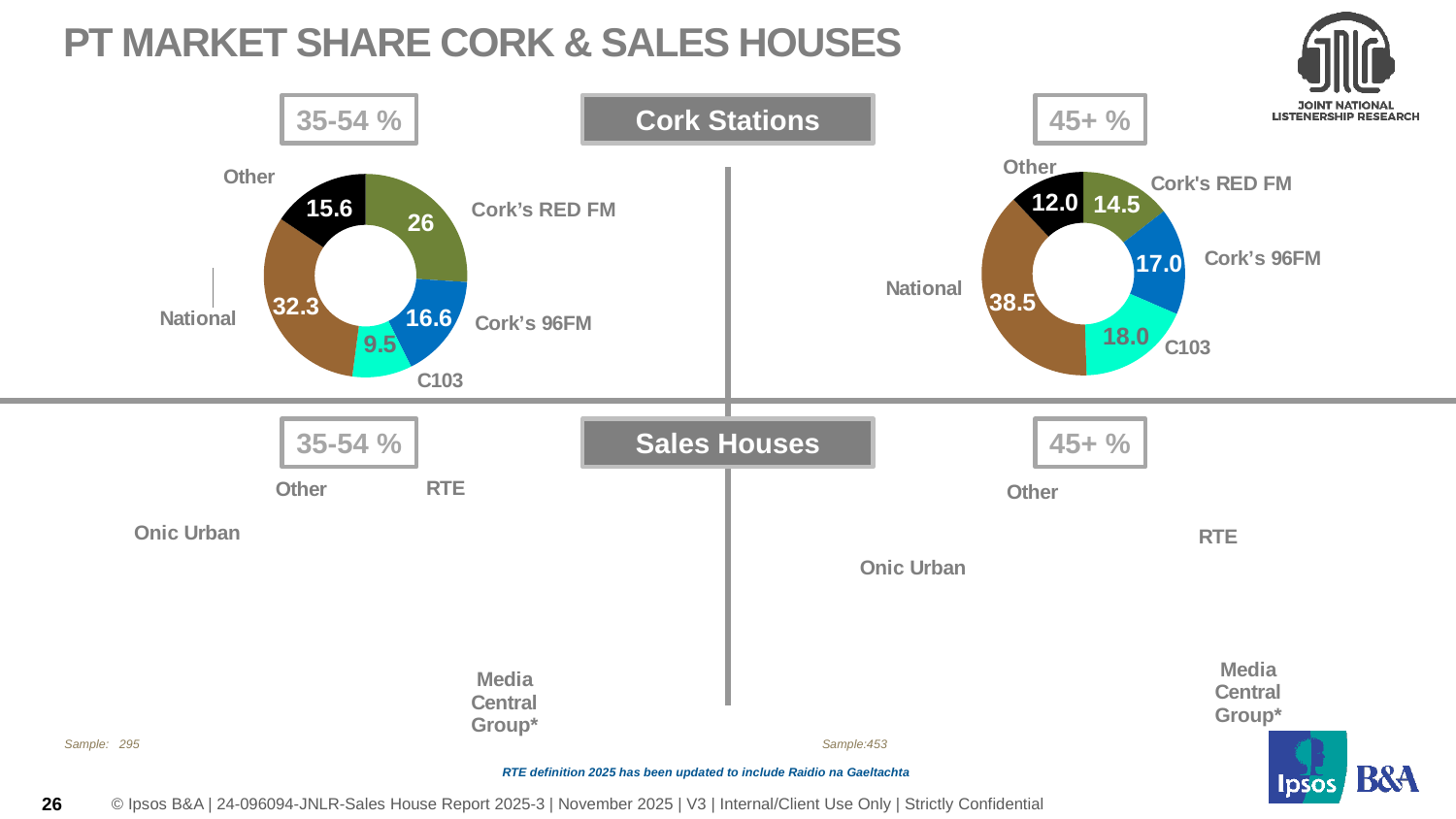
In the Cork Stations 35-54 chart, what is the value for National? 32.3 In the Cork Stations 45+ chart, which category has the smallest value? Other In the Cork Stations 35-54 chart, what is the difference between Cork's RED FM and C103? 16.5 In the Cork Stations 45+ chart, what is the value for Other? 12.0 In the Cork Stations 45+ chart, which is larger, Cork's RED FM or C103? C103 In the Cork Stations 35-54 chart, what is the value for Cork's RED FM? 26 In the Cork Stations 45+ chart, what is the value for C103? 18.0 In the Cork Stations 45+ chart, what is the difference between National and Cork's 96FM? 21.5 In the Cork Stations 35-54 chart, which category has the largest value? National How many categories are shown in the Cork Stations 35-54 chart? 5 In the Cork Stations 35-54 chart, which category has the smallest value? C103 What kind of chart is used for the Cork Stations 45+ data? Donut (pie) chart